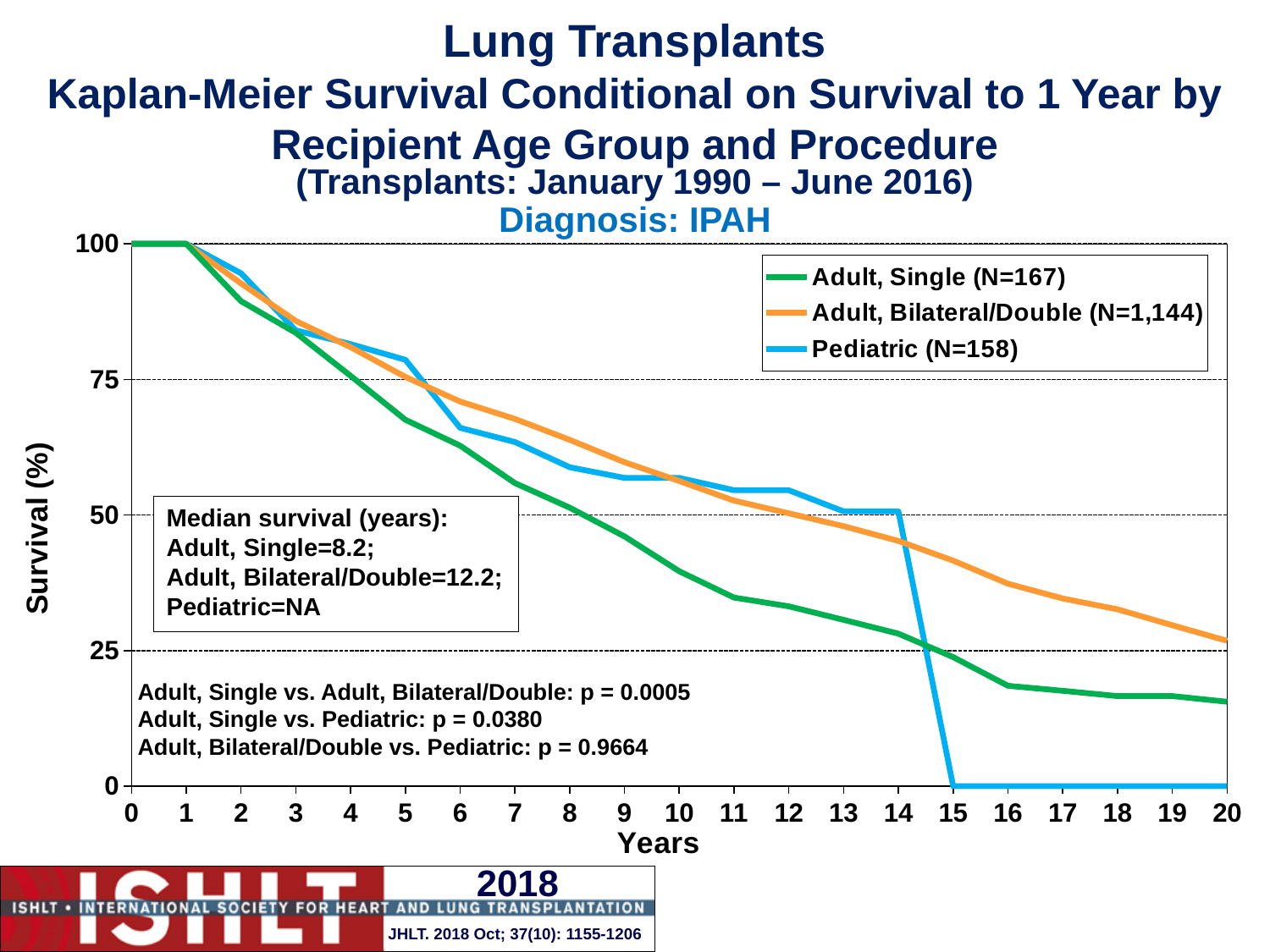
What is the survival (%) for the Pediatric group at year 16? 0 What is the median survival in years for Adult, Bilateral/Double recipients? 12.2 What is the p-value for Adult, Single vs. Pediatric shown on the slide? 0.0380 What kind of chart is shown on the slide? line chart Is the survival value for Adult, Single at year 10 greater or less than 50? less What is the median survival in years for Adult, Single recipients? 8.2 Do the survival curves rise or fall as years increase along the x axis? fall Is the survival value for Adult, Bilateral/Double at year 4 greater or less than 75? greater What is the N for the Adult, Single group shown in the legend? 167 At year 18, which series has the higher survival: Adult, Single or Adult, Bilateral/Double? Adult, Bilateral/Double What is the N for the Adult, Bilateral/Double group shown in the legend? 1,144 How many series does the legend list? 3